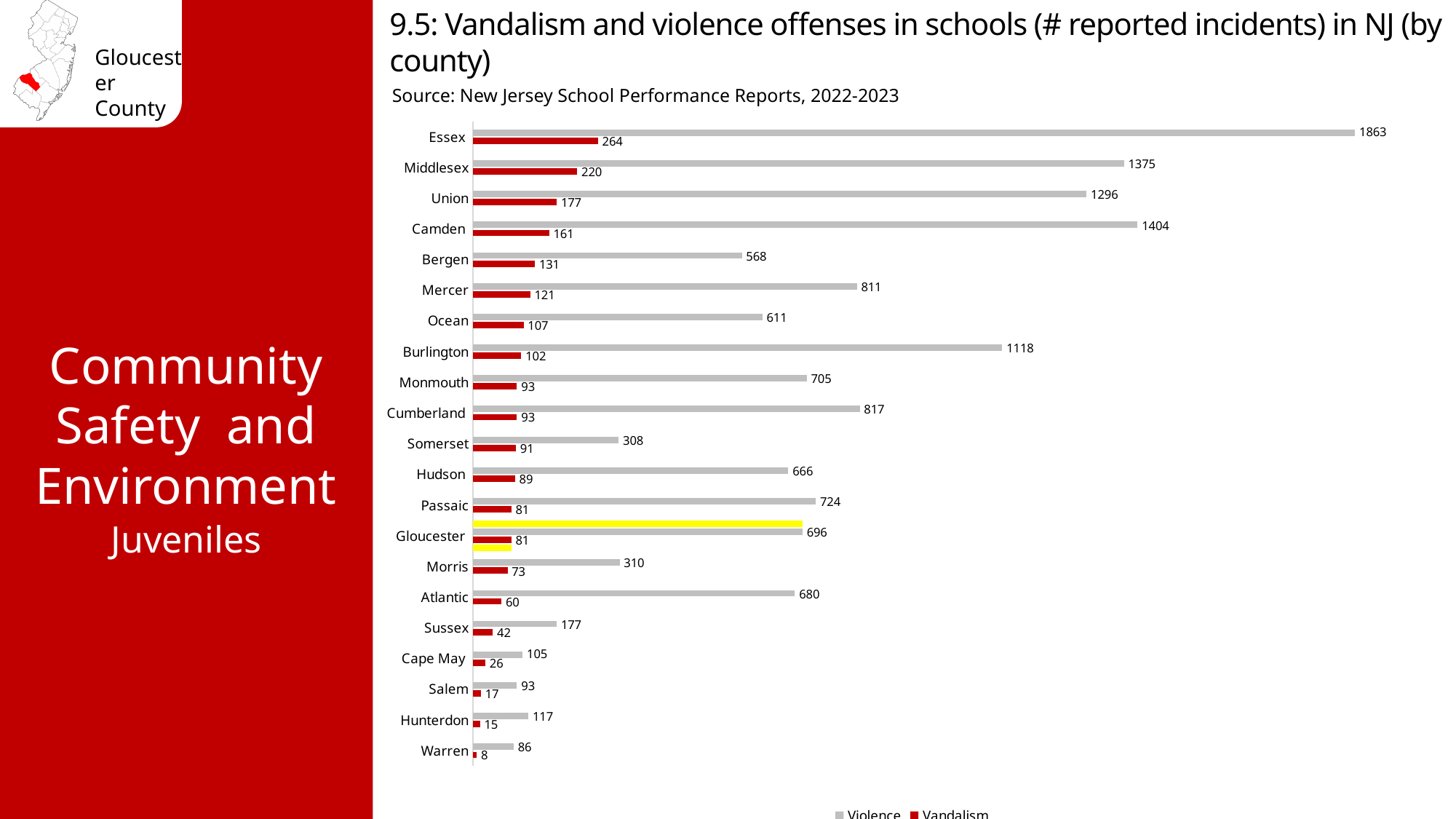
Which county has the lowest number of reported vandalism incidents? Warren What is the difference between the violence and vandalism incidents in Burlington County? 1016 Which county has more reported violence incidents, Camden or Union? Camden What is the difference between the violence incidents in Essex and Middlesex? 488 How many series does the legend list? 2 What is the number of reported violence incidents in schools for Gloucester County? 696 Which county has the highest number of reported violence incidents? Essex How many counties are shown in the chart? 21 Which county's bars are highlighted in yellow on the chart? Gloucester Which county has more reported vandalism incidents, Bergen or Mercer? Bergen What is the number of reported vandalism incidents in schools for Camden County? 161 What kind of chart is shown on the slide? Bar chart